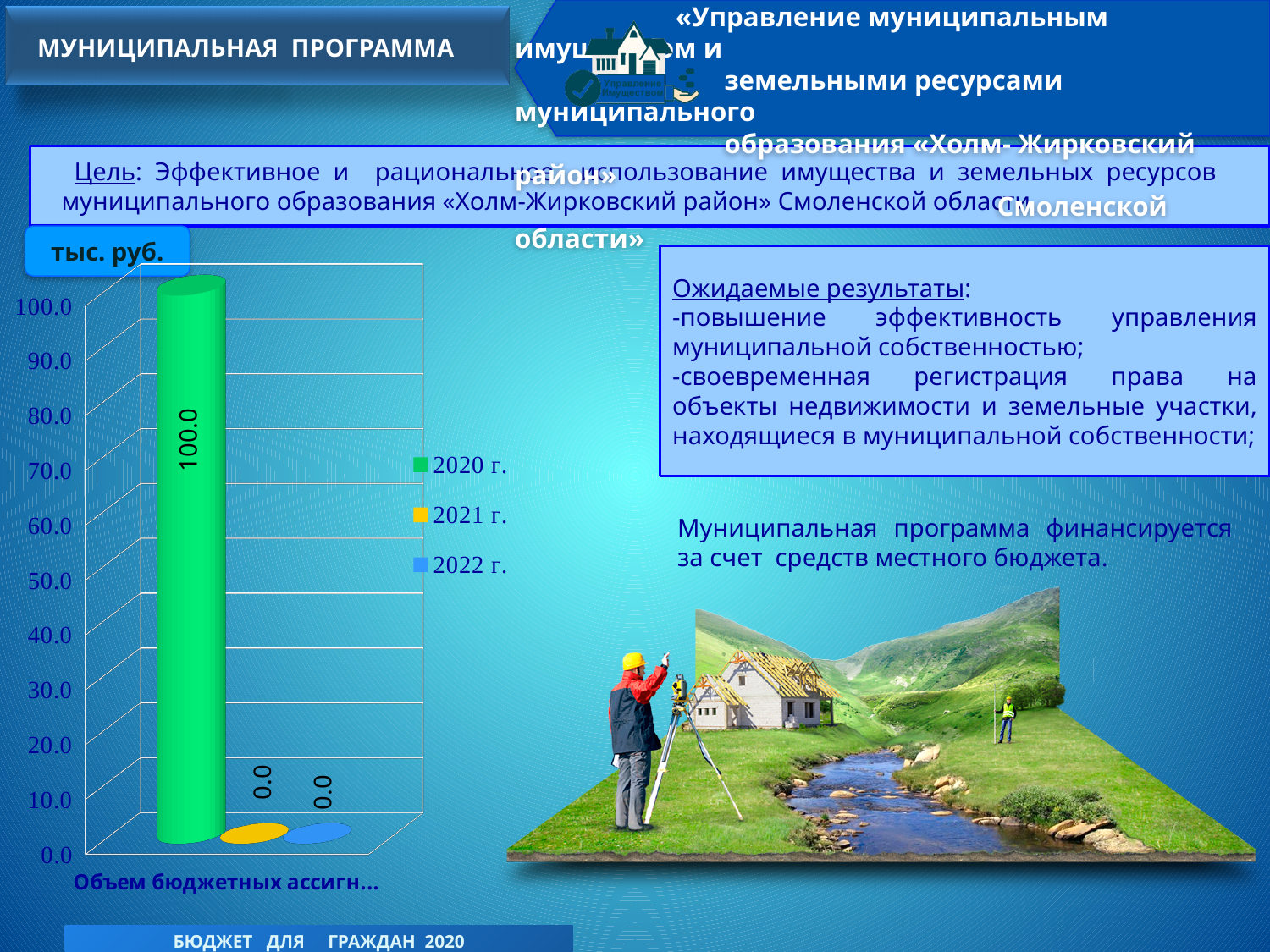
What is the difference between the values for 2020 г. and 2021 г.? 100.0 What is the highest tick value shown on the vertical axis of the chart? 100.0 What is the total of the values for 2020 г., 2021 г. and 2022 г.? 100.0 Is the value for 2020 г. greater or less than 50.0? greater Which is larger, the value for 2020 г. or the value for 2022 г.? 2020 г. What kind of chart is shown on the slide? bar chart What is the value for 2021 г. on the chart? 0.0 What is the value for 2022 г. on the chart? 0.0 What is the value for 2020 г. on the chart? 100.0 How many series does the legend list? 3 Which year has the highest value on the chart? 2020 г. What unit label is shown above the chart? тыс. руб.